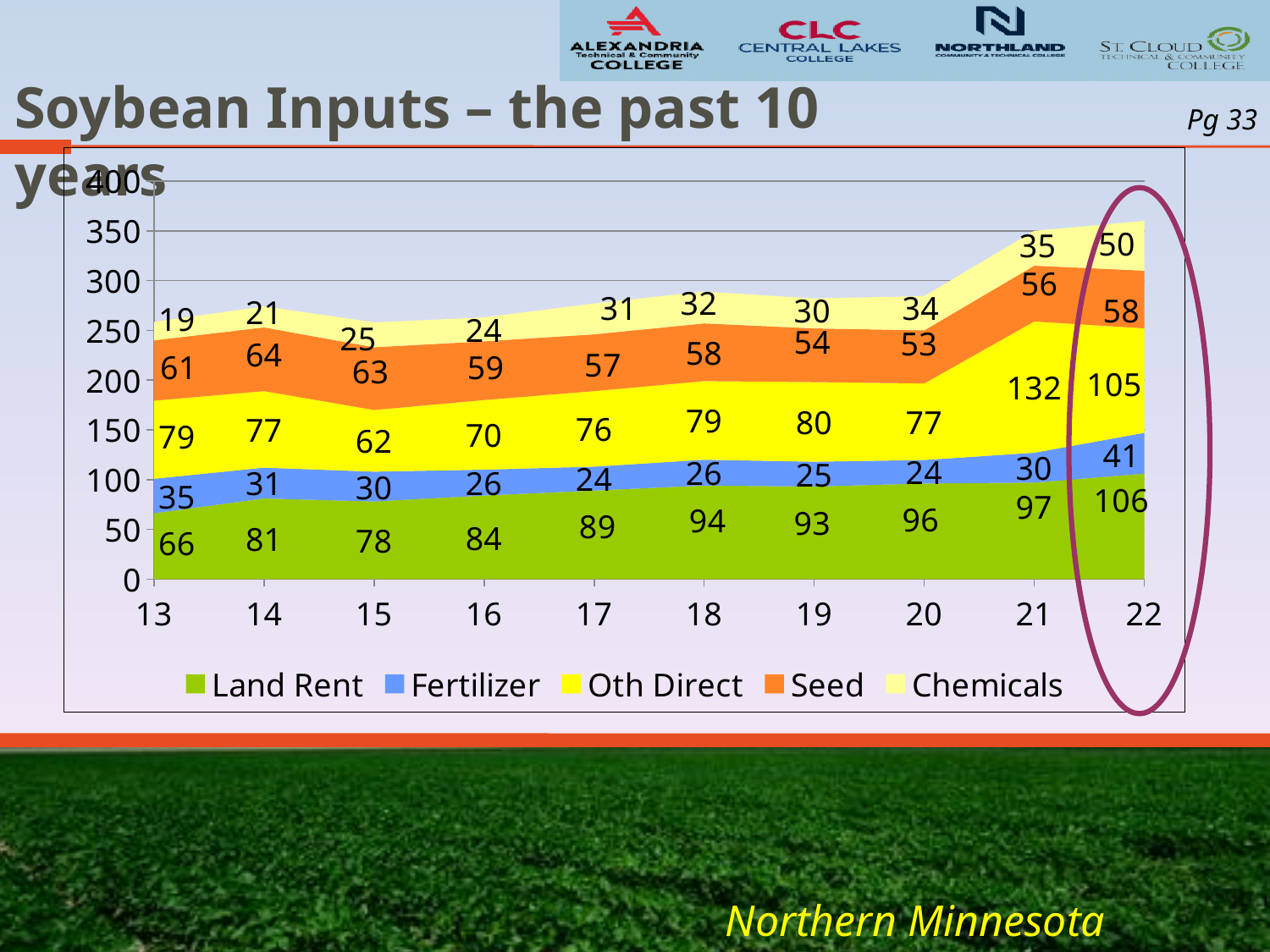
In which year is Land Rent highest? 22 In which year is Fertilizer lowest? 17 and 20 How many years are shown on the x axis? 10 Which is larger, the Seed value in year 14 or the Seed value in year 20? Seed in year 14 What is the total of all five inputs for year 22? 360 What is the Land Rent value for year 22? 106 How many series does the legend list? 5 What is the Chemicals value for year 13? 19 What is the Seed value for year 17? 57 What is the difference between the Land Rent value in year 22 and in year 13? 40 What is the Oth Direct value for year 21? 132 What kind of chart is shown? Stacked area chart